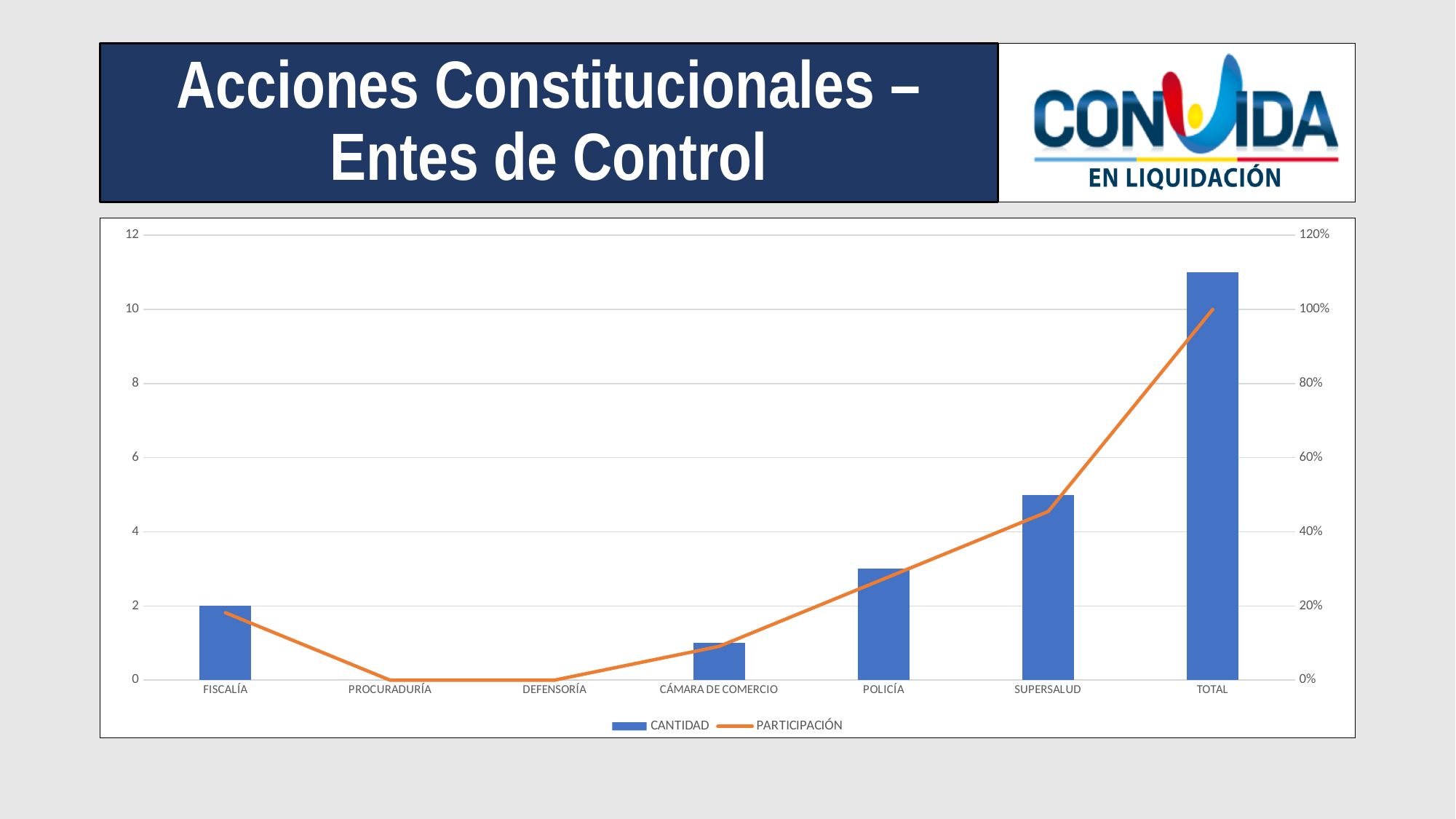
Is the PARTICIPACIÓN value for SUPERSALUD greater or less than 40%? greater What kind of chart is shown on the slide? Combination bar and line chart What is the CANTIDAD value for PROCURADURÍA? 0 How many series does the legend list? 2 Is the CANTIDAD value for TOTAL greater or less than 10? greater Is the CANTIDAD value for SUPERSALUD greater or less than 4? greater How many categories are shown on the x axis? 7 Which category has the highest CANTIDAD bar? TOTAL What is the PARTICIPACIÓN value for TOTAL? 100% What is the CANTIDAD value for FISCALÍA? 2 What is the difference between the CANTIDAD values for FISCALÍA and DEFENSORÍA? 2 Which has a larger CANTIDAD value, POLICÍA or CÁMARA DE COMERCIO? POLICÍA